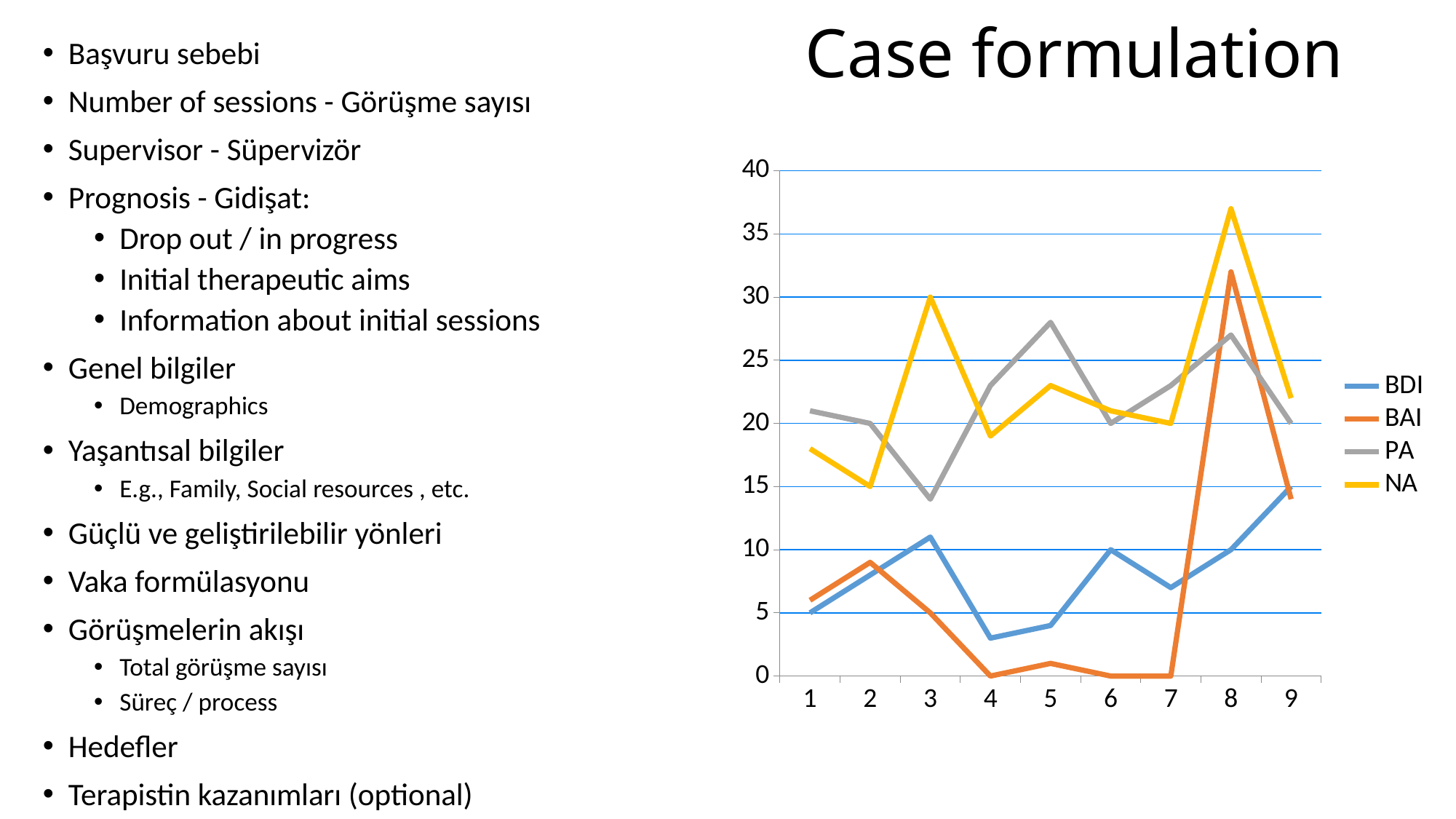
What is the value of BAI at point 4? 0 Is the value of BDI at point 4 greater or less than 5? less Is the value of BAI at point 8 greater or less than 30? greater At point 5, which is larger, PA or NA? PA How many points are on the x axis of the chart? 9 What is the value of NA at point 3? 30 Does the BDI line rise or fall from point 7 to point 9? rise Is the value of NA at point 8 greater or less than 35? greater What is the value of BAI at point 7? 0 What kind of chart is shown on the slide? line chart How many series does the chart legend list? 4 Which series reaches the highest value on the chart? NA